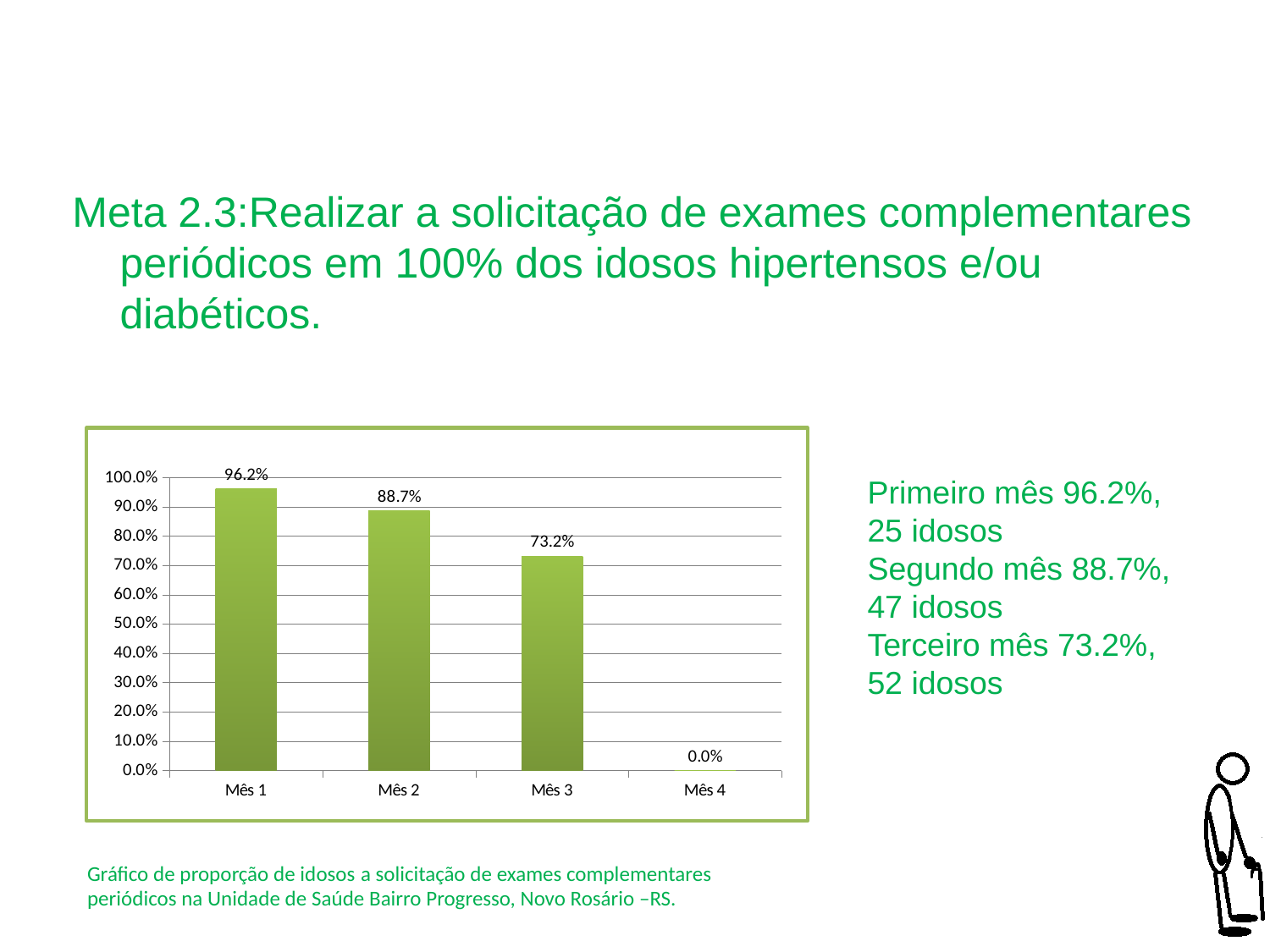
What is the difference between the values for Mês 1 and Mês 3? 23.0% What is the value for Mês 1? 96.2% What kind of chart is shown on the slide? Bar chart Do the values rise or fall from Mês 1 to Mês 4? Fall What is the value for Mês 4? 0.0% What is the difference between the values for Mês 2 and Mês 3? 15.5% What is the value for Mês 2? 88.7% Which month has the lowest value? Mês 4 Which is larger, the value for Mês 2 or the value for Mês 3? Mês 2 What is the value for Mês 3? 73.2% Which month has the highest value? Mês 1 How many months are shown on the x axis? 4